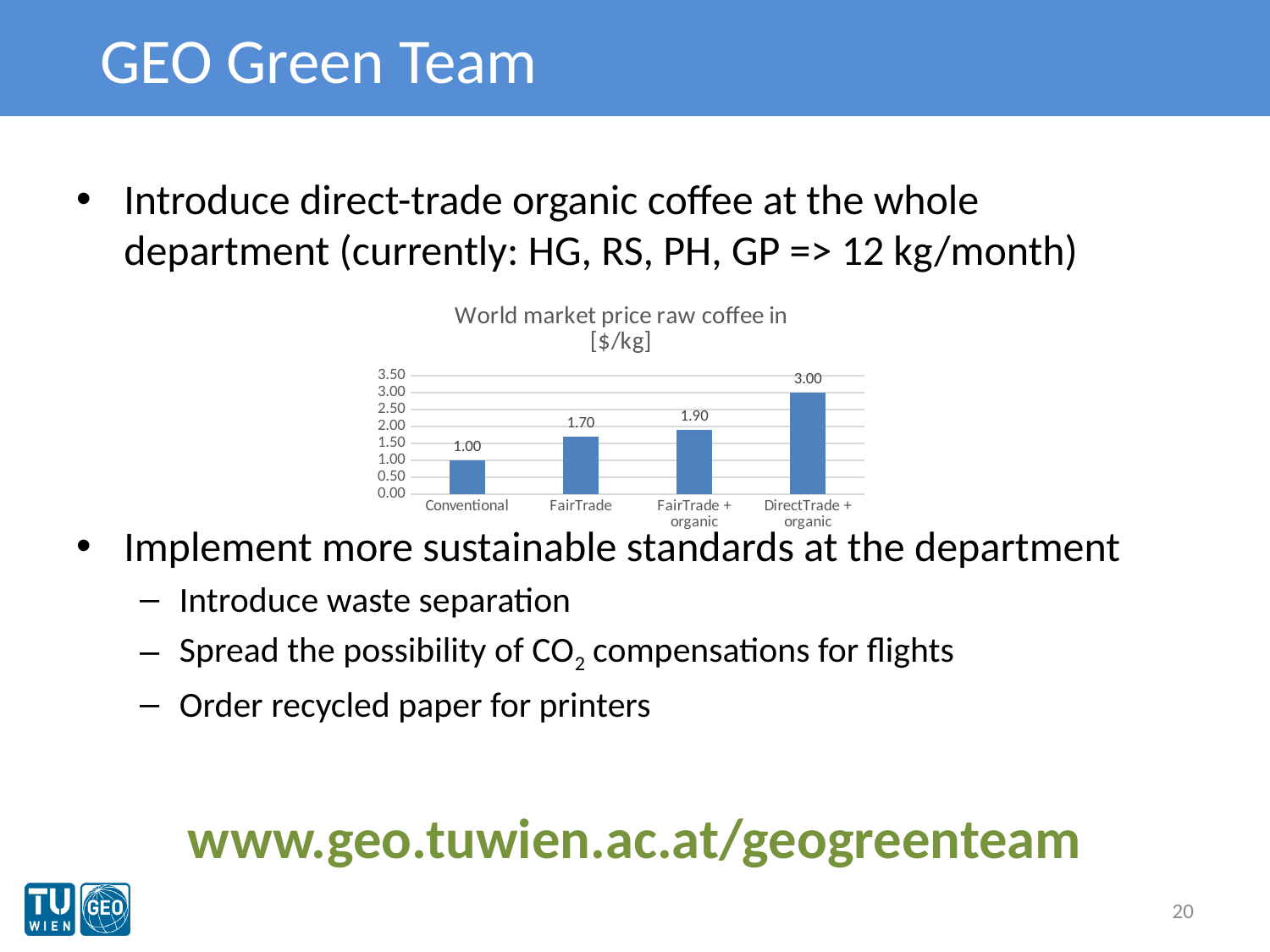
What is the world market price of raw coffee for DirectTrade + organic? 3.00 What is the world market price of raw coffee for FairTrade? 1.70 What is the world market price of raw coffee for FairTrade + organic? 1.90 Which is priced higher, FairTrade or FairTrade + organic? FairTrade + organic Which category has the lowest world market price for raw coffee? Conventional What is the difference in price between FairTrade + organic and FairTrade coffee? 0.20 How many categories are shown in the chart? 4 What is the world market price of raw coffee for Conventional? 1.00 Which category has the highest world market price for raw coffee? DirectTrade + organic Do the prices rise or fall from left to right across the categories? Rise What is the difference in price between DirectTrade + organic and Conventional coffee? 2.00 What type of chart is used to show the world market price of raw coffee? Bar chart